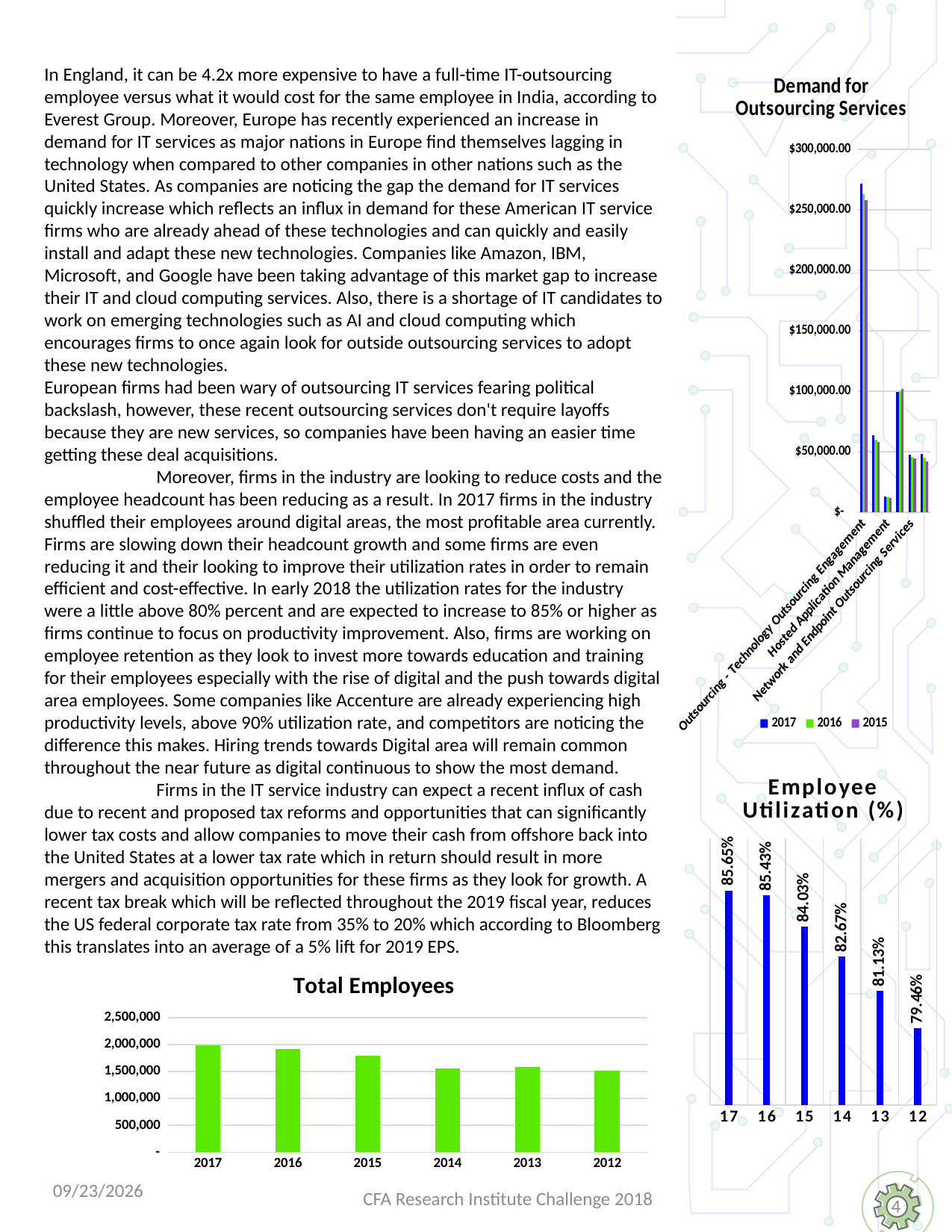
In the Employee Utilization (%) chart, how many bars are plotted? 6 In the Demand for Outsourcing Services chart, is the 2017 value for Hosted Application Management greater or less than $50,000.00? less In the Employee Utilization (%) chart, which category has the lowest value? 12 In the Demand for Outsourcing Services chart, how many series does the legend list? 3 In the Employee Utilization (%) chart, what is the value for 17? 85.65% In the Employee Utilization (%) chart, what is the difference between the values for 15 and 14? 1.36% What kind of chart is the Total Employees chart? bar chart In the Total Employees chart, which year has the highest value? 2017 In the Total Employees chart, which is larger, the value for 2016 or the value for 2014? 2016 In the Employee Utilization (%) chart, do the values rise or fall moving from 17 to 12 along the x axis? fall In the Employee Utilization (%) chart, what is the value for 12? 79.46% In the Total Employees chart, is the value for 2017 greater or less than 1,500,000? greater